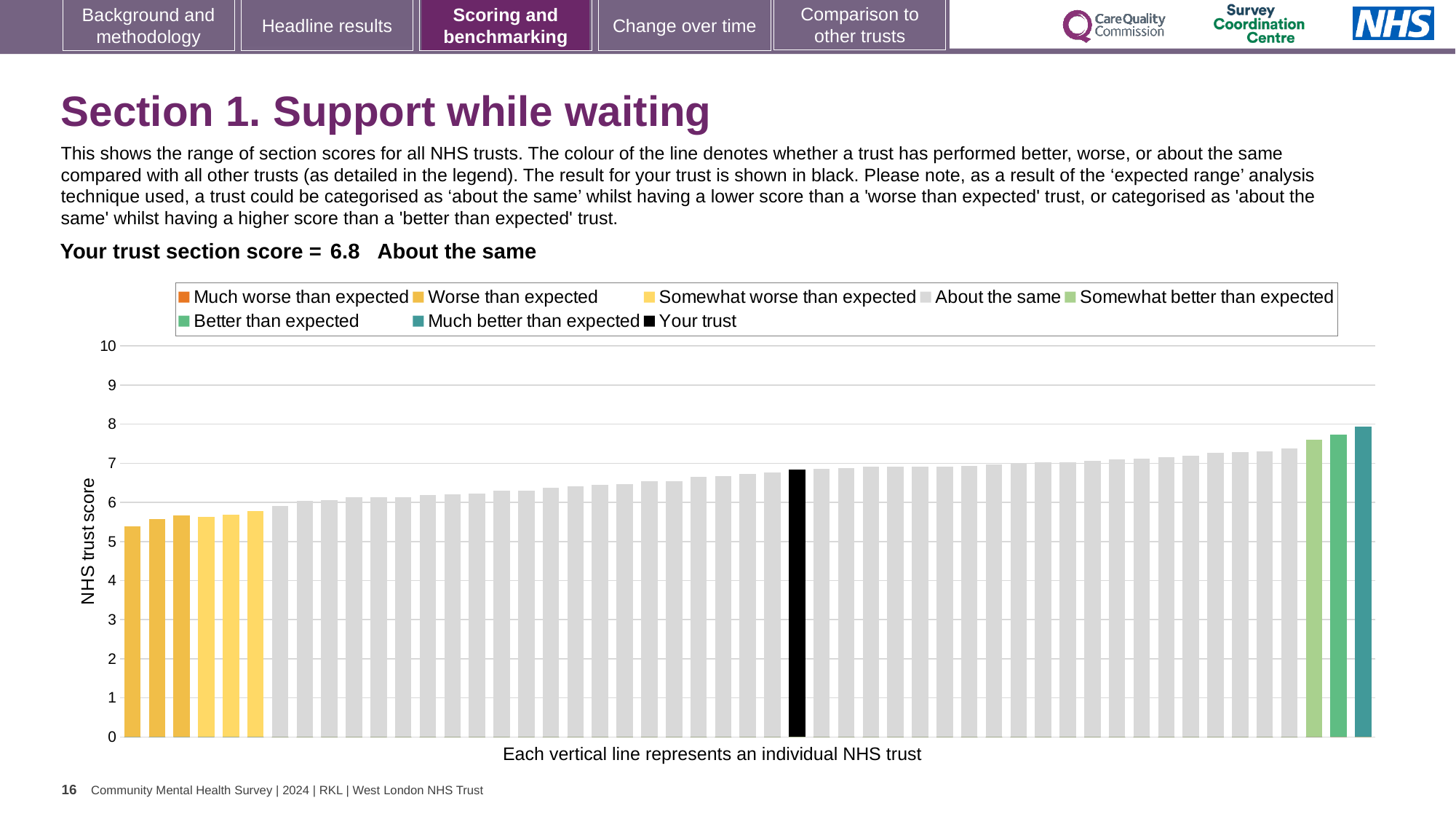
Is the value of the tallest bar greater or less than 7? greater How many bars are shown in the 'Better than expected' colour? 1 Is the value of the leftmost bar greater or less than 6? less What kind of chart is shown on the slide? bar chart Is the value of the black 'Your trust' bar greater or less than 6? greater Do the bar values rise or fall from left to right along the x axis? rise What is the label on the vertical axis of the chart? NHS trust score Which legend category does the tallest bar belong to? Much better than expected Which performance category is your trust placed in for this section? About the same Which is taller, the black 'Your trust' bar or the leftmost bar? the black 'Your trust' bar How many entries does the chart legend list? 8 What is the section score for your trust shown on the slide? 6.8